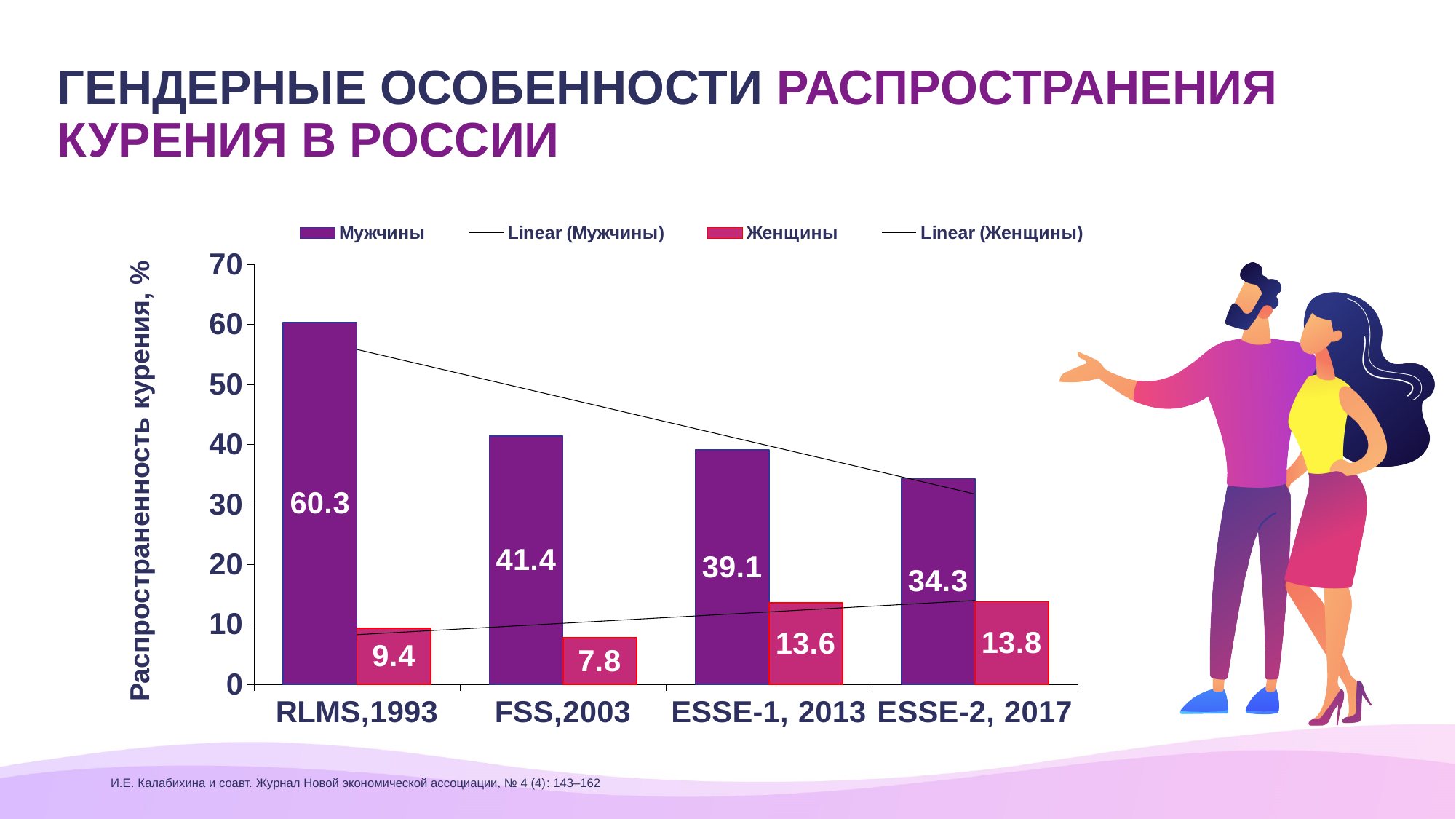
Is the value for Мужчины at ESSE-1, 2013 greater or less than 40? less What is the value for Женщины at ESSE-2, 2017? 13.8 Which category has the lowest value for Женщины? FSS,2003 How many categories are shown on the x axis? 4 Do the Мужчины values rise or fall from RLMS,1993 to ESSE-2, 2017? fall What is the value for Женщины at FSS,2003? 7.8 Which is larger: the Мужчины value at FSS,2003 or at ESSE-2, 2017? FSS,2003 Which category has the highest value for Мужчины? RLMS,1993 What is the value for Мужчины at RLMS,1993? 60.3 How many entries does the legend list? 4 What kind of chart is shown on the slide? bar chart What is the difference between the Мужчины and Женщины values at ESSE-1, 2013? 25.5